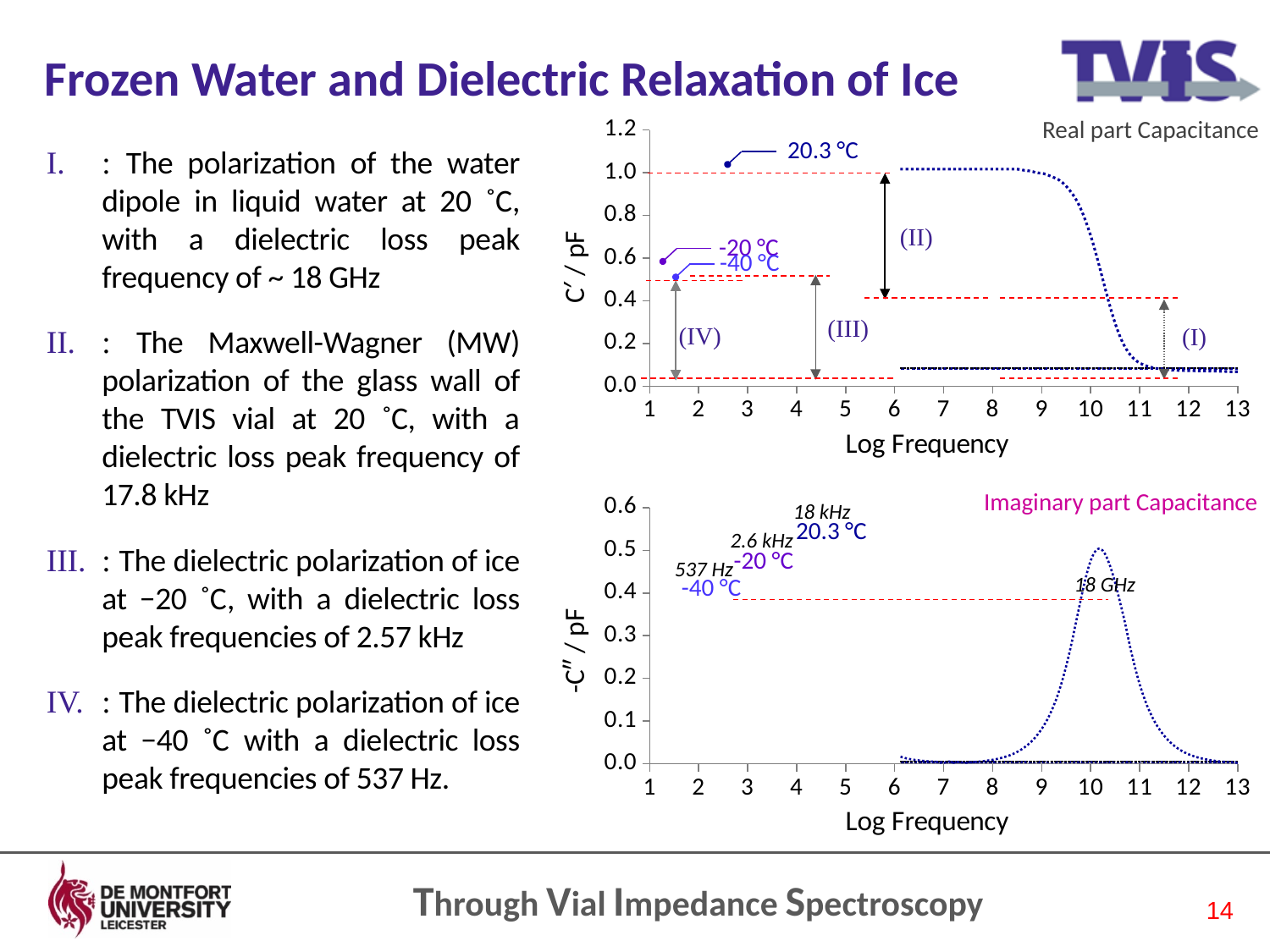
In the Real part Capacitance chart, is the value of the dotted curve at log frequency 12 greater or less than 0.2? less In the Imaginary part Capacitance chart, does the dotted curve rise or fall between log frequency 8 and log frequency 10? rise In the Real part Capacitance chart, is the value of the dotted curve at log frequency 8 greater or less than 0.8? greater In the Imaginary part Capacitance chart, is the value of the dotted curve at log frequency 7 greater or less than 0.1? less In the Imaginary part Capacitance chart, what peak frequency is labelled next to -40 °C? 537 Hz What is the y-axis label of the Imaginary part Capacitance chart? -C'' / pF In the Imaginary part Capacitance chart, what frequency is labelled at the peak of the dotted curve? 18 GHz What kind of chart is the Real part Capacitance chart? line chart In the Real part Capacitance chart, does the dotted curve rise or fall between log frequency 9 and log frequency 11? fall What is the x-axis title of the Real part Capacitance chart? Log Frequency In the Imaginary part Capacitance chart, what peak frequency is labelled next to -20 °C? 2.6 kHz